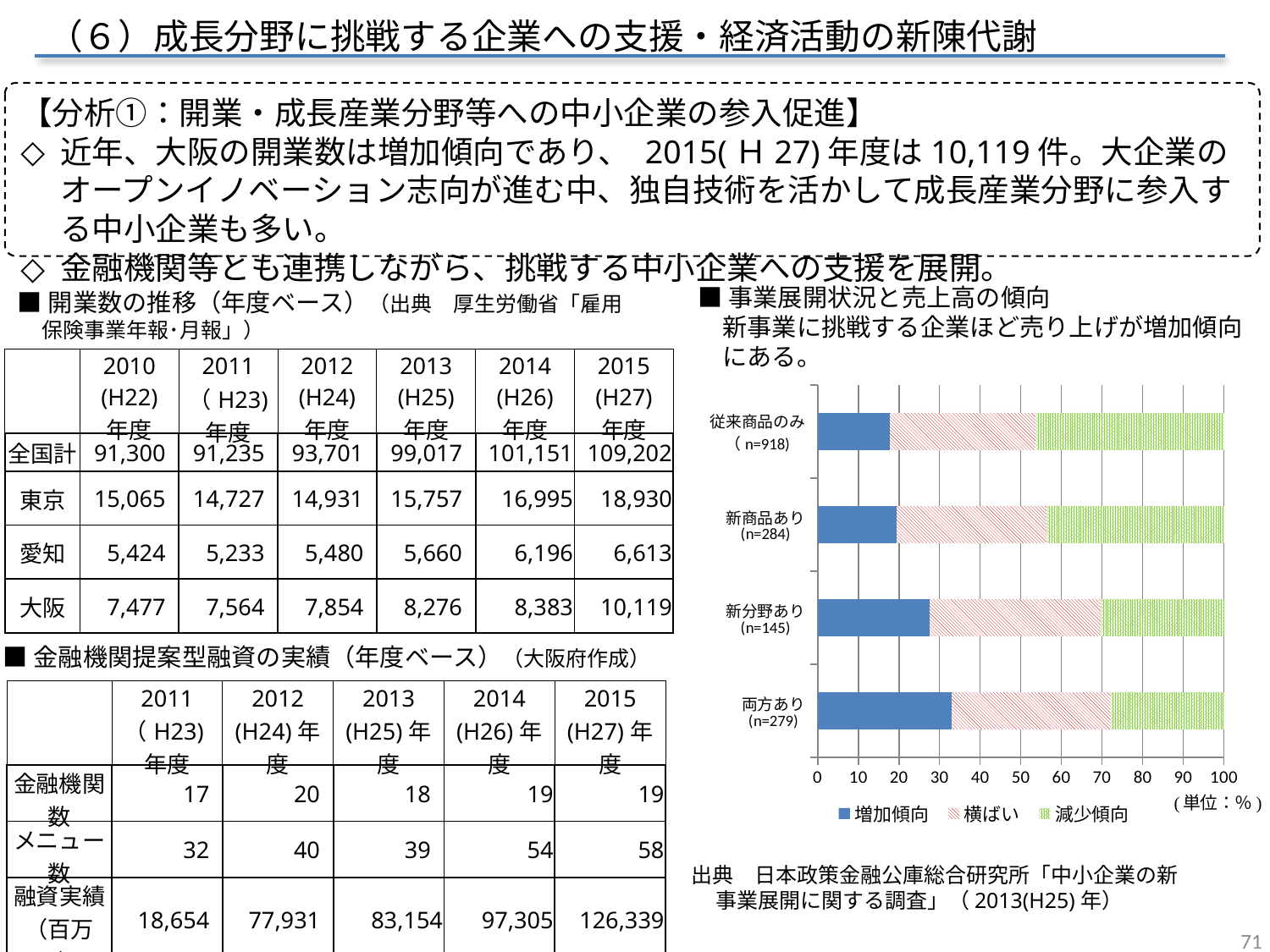
How many categories (bars) does the 事業展開状況と売上高の傾向 chart show? 4 How many series does the legend of the 事業展開状況と売上高の傾向 chart list? 3 What kind of chart is shown on the right side of the slide under 事業展開状況と売上高の傾向? Stacked horizontal bar chart In the 事業展開状況と売上高の傾向 chart, is the 増加傾向 value for 両方あり greater or less than 30? greater In the 事業展開状況と売上高の傾向 chart, which has the larger 減少傾向 share: 従来商品のみ or 両方あり? 従来商品のみ What are the three legend entries of the 事業展開状況と売上高の傾向 chart? 増加傾向, 横ばい, 減少傾向 What unit is indicated for the x axis of the 事業展開状況と売上高の傾向 chart? % In the 事業展開状況と売上高の傾向 chart, which has the larger 増加傾向 share: 新分野あり or 新商品あり? 新分野あり In the 事業展開状況と売上高の傾向 chart, is the 増加傾向 value for 新分野あり greater or less than 20? greater In the 事業展開状況と売上高の傾向 chart, which category has the largest 増加傾向 share? 両方あり What is the sample size (n) shown for the 従来商品のみ category in the 事業展開状況と売上高の傾向 chart? n=918 In the 事業展開状況と売上高の傾向 chart, is the 増加傾向 value for 従来商品のみ greater or less than 30? less